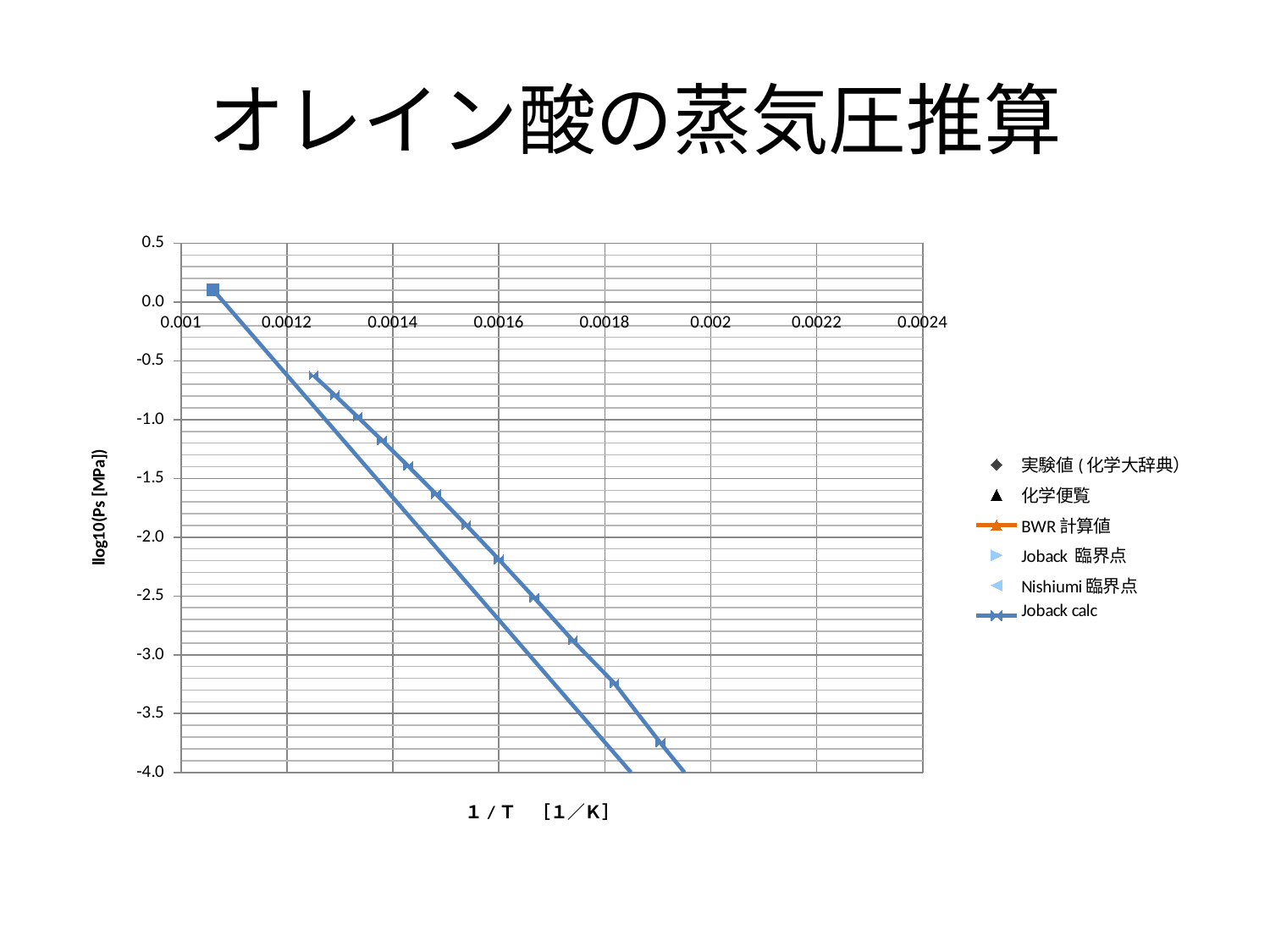
What is the label of the y axis? llog10(Ps [MPa]) Is the Joback calc value at 1/T = 0.0016 greater or less than -2.5? greater Is the Joback calc value at 1/T = 0.0014 greater or less than -1.0? less Is the Joback calc value at 1/T = 0.0014 greater or less than -1.5? greater As 1/T increases along the x axis, do the plotted log10(Ps) values rise or fall? fall How many series does the legend list? 6 What kind of chart is shown on the slide? line chart What is the title of the slide containing the chart? オレイン酸の蒸気圧推算